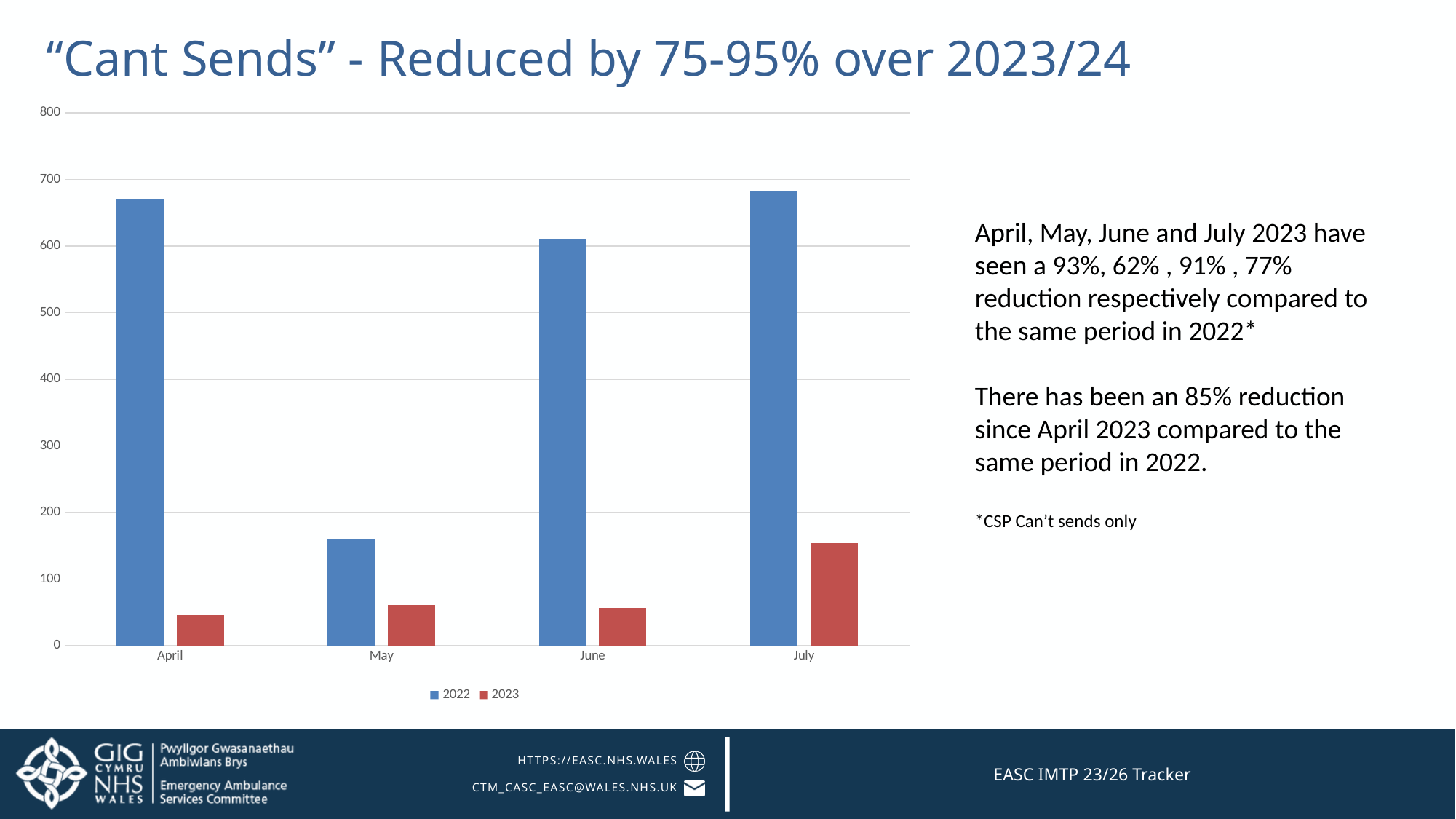
Is the value for April in the 2022 series greater or less than 600? greater Which month has the lowest value for the 2022 series? May How many months are shown on the x axis of the chart? 4 What kind of chart is shown on the slide? bar chart Which is larger in the 2022 series, the value for June or the value for July? July Which month has the highest value for the 2023 series? July How many series does the chart legend list? 2 Which is larger in the 2023 series, the value for May or the value for July? July Is the value for April in the 2023 series greater or less than 100? less Which colour represents the 2023 series in the chart? red Is the value for July in the 2023 series greater or less than 100? greater